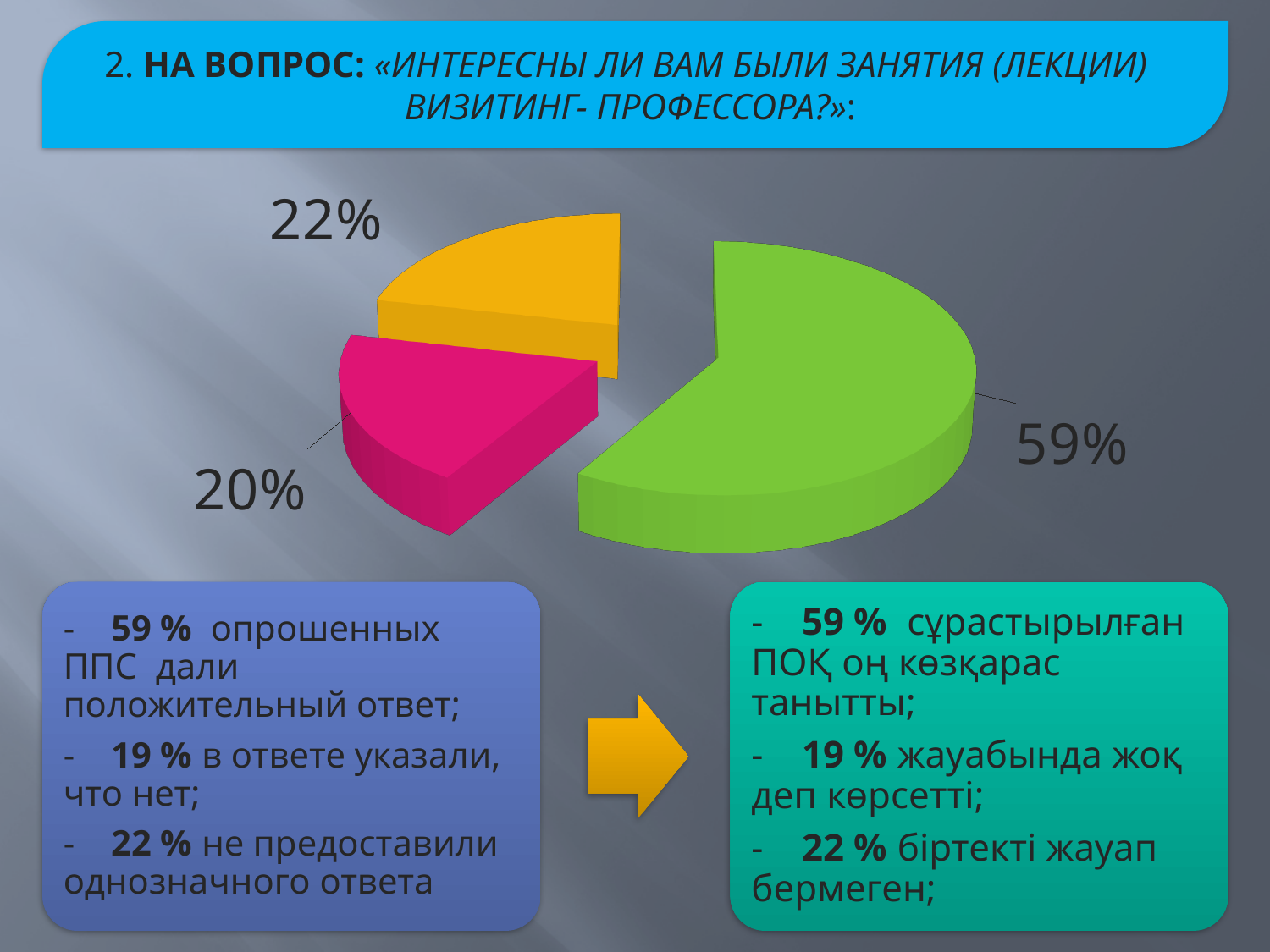
Is the value of the green slice greater or less than 50%? greater What value is labelled on the pink slice of the pie chart? 20% What is the difference between the yellow slice and the pink slice in the pie chart? 2% Which slice of the pie chart has the smallest value? the pink slice (20%) Which is larger in the pie chart, the green slice or the pink slice? the green slice What kind of chart is shown on the slide? pie chart What colour is the largest slice of the pie chart? green What value is labelled on the green slice of the pie chart? 59% Which slice of the pie chart has the largest value? the green slice (59%) What value is labelled on the yellow slice of the pie chart? 22% What is the difference between the green slice and the yellow slice in the pie chart? 37% How many slices does the pie chart have? 3